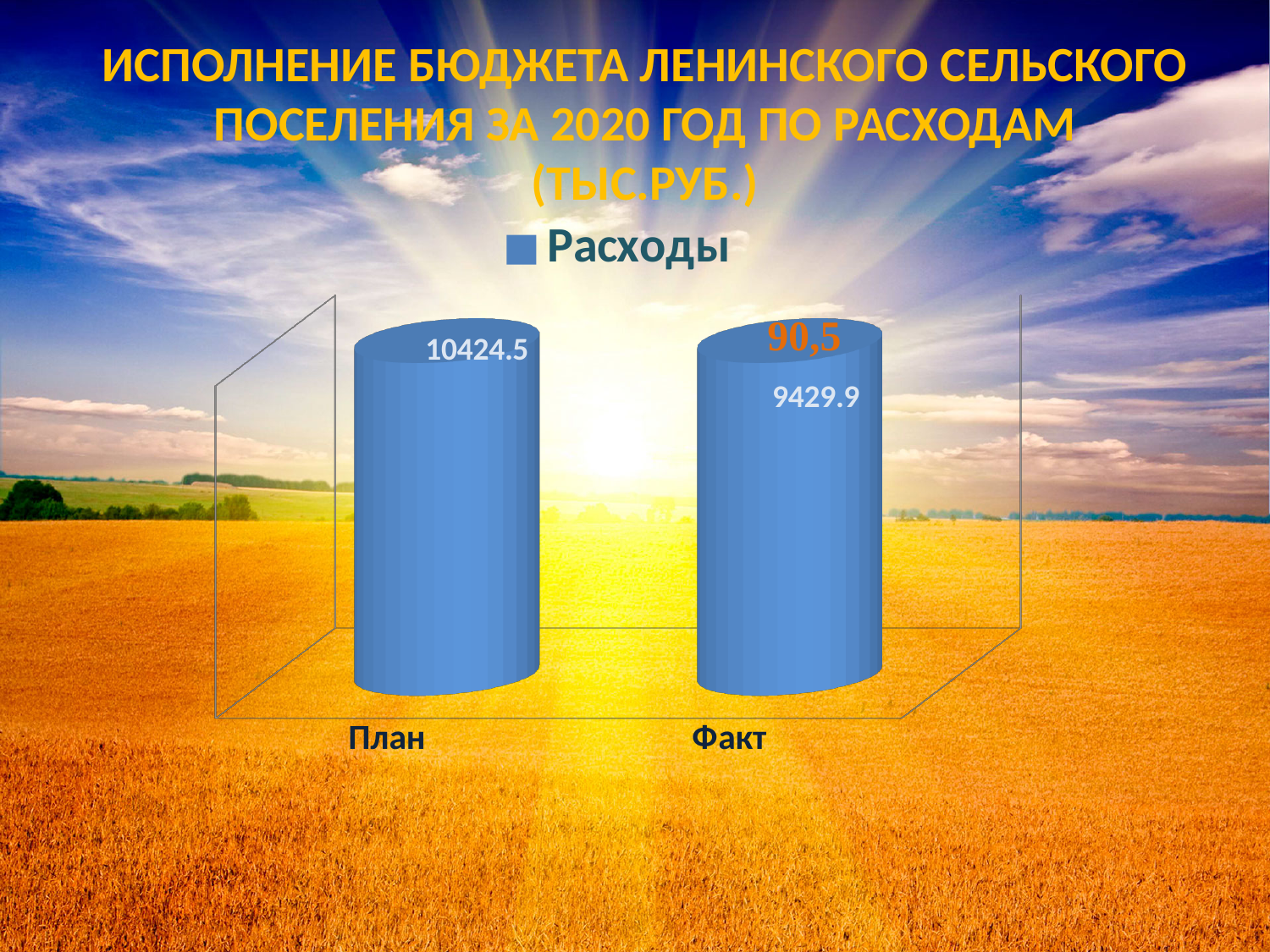
What is the difference between the values for План and Факт? 994.6 What series name is shown in the chart legend? Расходы Do the values rise or fall from План to Факт? Fall What orange number is printed above the Факт bar? 90,5 How many categories are shown on the chart? 2 Which category has the lowest value? Факт What is the value for План? 10424.5 How many series does the legend list? 1 Which category has the higher value, План or Факт? План Which category has the highest value? План What kind of chart is shown on the slide? Bar chart What is the value for Факт? 9429.9